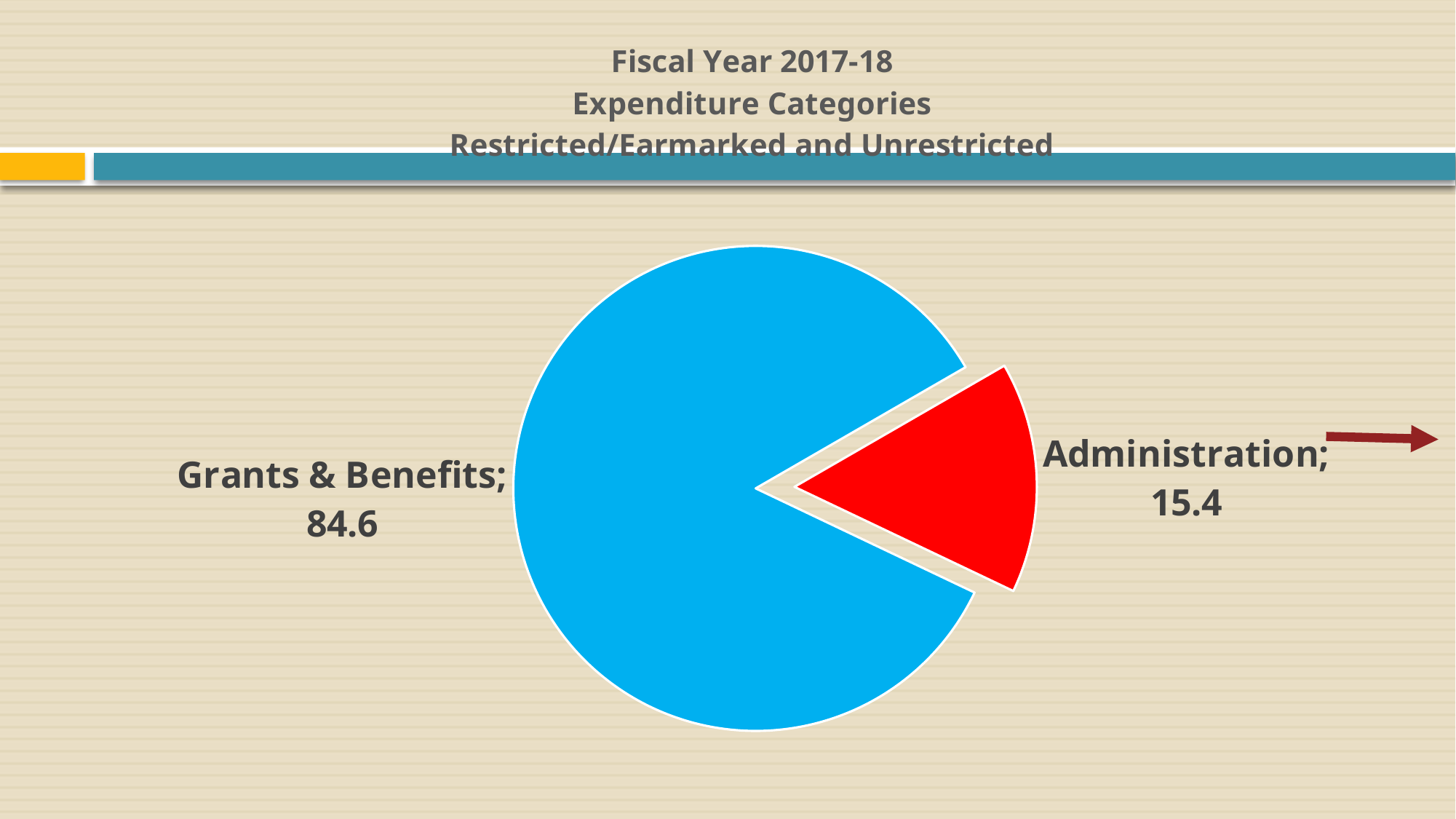
What colour is the Administration slice? red Which category has the smallest slice of the pie? Administration What is the value for Grants & Benefits? 84.6 How many slices does the pie chart have? 2 What is the value for Administration? 15.4 What is the difference between the values for Grants & Benefits and Administration? 69.2 What is the total of the two slice values shown? 100 What fiscal year does the chart title refer to? Fiscal Year 2017-18 Which is larger, Grants & Benefits or Administration? Grants & Benefits What kind of chart is shown on the slide? pie chart Which category has the largest slice of the pie? Grants & Benefits